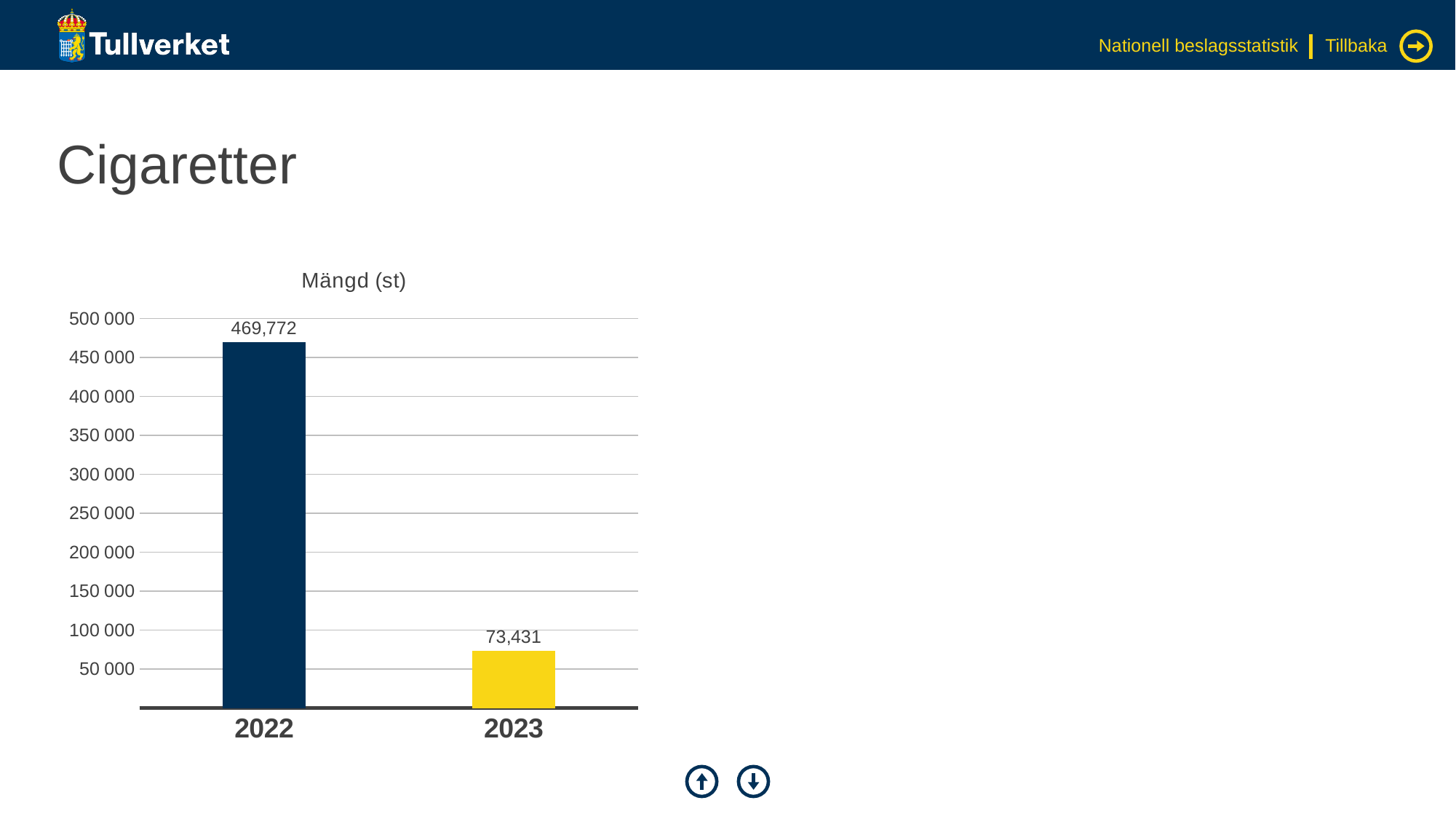
Which year has the highest value in the Mängd (st) chart? 2022 What is the difference between the 2022 and 2023 values in the Mängd (st) chart? 396,341 Which year has the lowest value in the Mängd (st) chart? 2023 Is the value for 2022 in the Mängd (st) chart greater or less than 450 000? greater Which is larger in the Mängd (st) chart, the value for 2022 or 2023? 2022 What is the title of the chart on the slide? Mängd (st) What is the value for 2022 in the Mängd (st) chart? 469,772 Do the values rise or fall from 2022 to 2023 in the Mängd (st) chart? Fall What is the value for 2023 in the Mängd (st) chart? 73,431 Is the value for 2023 in the Mängd (st) chart greater or less than 100 000? less How many years are shown in the Mängd (st) chart? 2 What kind of chart is shown on the slide? Bar chart